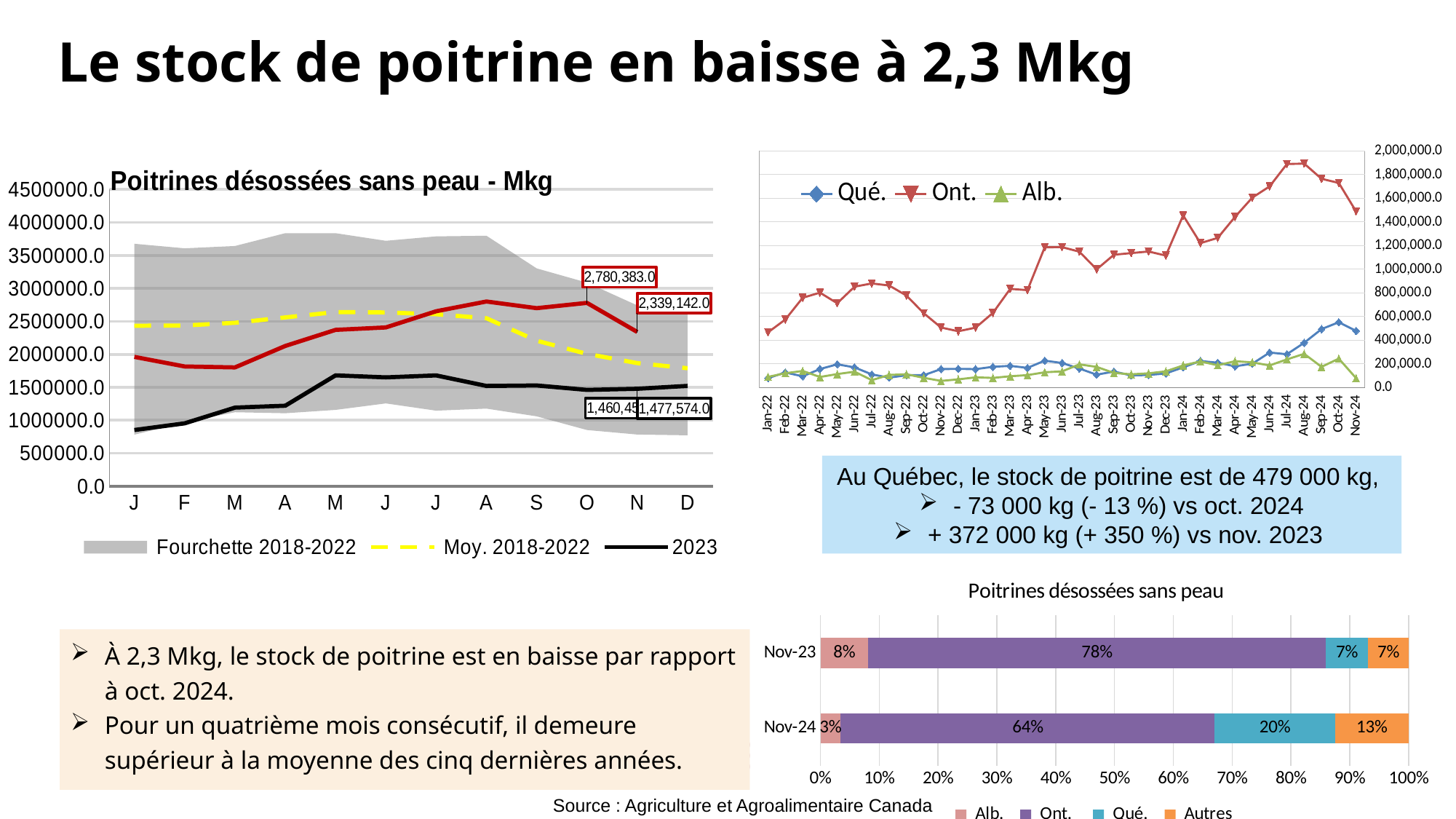
In the left chart 'Poitrines désossées sans peau - Mkg', what value is labelled on the 2023 line at N? 1,477,574.0 How many series does the legend of the bottom-right chart 'Poitrines désossées sans peau' list? 4 How many series does the legend of the top-right line chart list? 3 In the top-right line chart, is the Ont. value in Jul-24 greater or less than 1,800,000.0? greater In the bottom-right chart 'Poitrines désossées sans peau', by how many percentage points did the Qué. share change from Nov-23 to Nov-24? 13 percentage points What kind of chart is the bottom-right chart 'Poitrines désossées sans peau'? Stacked bar chart In the bottom-right chart 'Poitrines désossées sans peau', is the Autres share larger in Nov-23 or Nov-24? Nov-24 In the left chart 'Poitrines désossées sans peau - Mkg', is the 2023 value in J greater or less than 1000000.0? less In the bottom-right chart 'Poitrines désossées sans peau', what is the share of Ont. in Nov-24? 64% In the bottom-right chart 'Poitrines désossées sans peau', what is the share of Qué. in Nov-23? 7% In the left chart 'Poitrines désossées sans peau - Mkg', what value is labelled on the red line at N? 2,339,142.0 In the bottom-right chart 'Poitrines désossées sans peau', which region has the largest share in Nov-24? Ont.